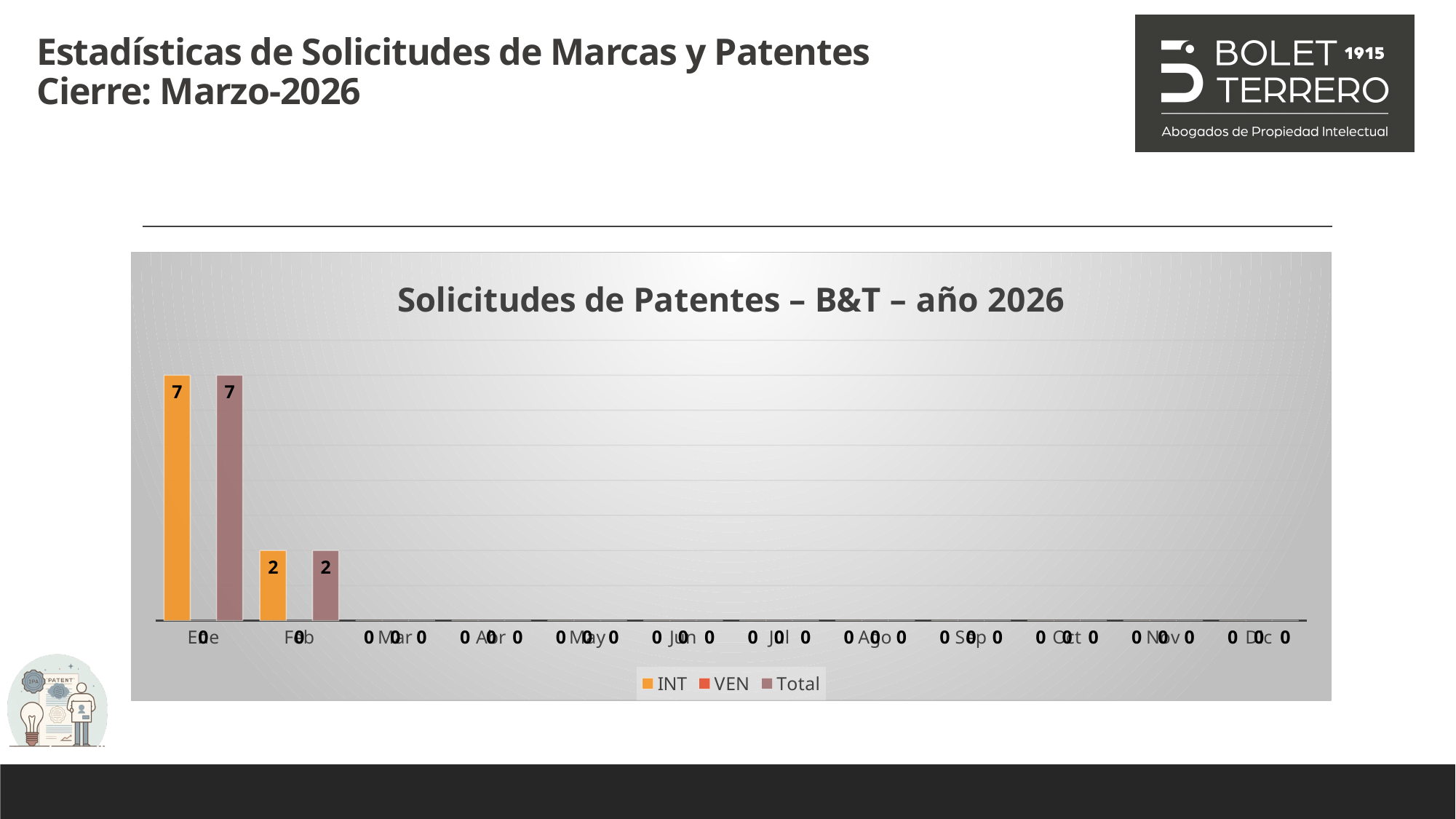
How many month categories are shown on the x axis of the chart? 12 Which is larger, the Total value for Ene or the Total value for Feb? Ene How many series does the chart legend list? 3 What is the difference between the INT value for Ene and the INT value for Feb? 5 What is the VEN value for Ene? 0 Which month has the highest Total value? Ene Which series is shown in orange in the legend? INT What is the INT value for Ene? 7 What is the title of the chart? Solicitudes de Patentes – B&T – año 2026 What is the INT value for Mar? 0 What is the Total value for Feb? 2 What kind of chart is shown on the slide? bar chart